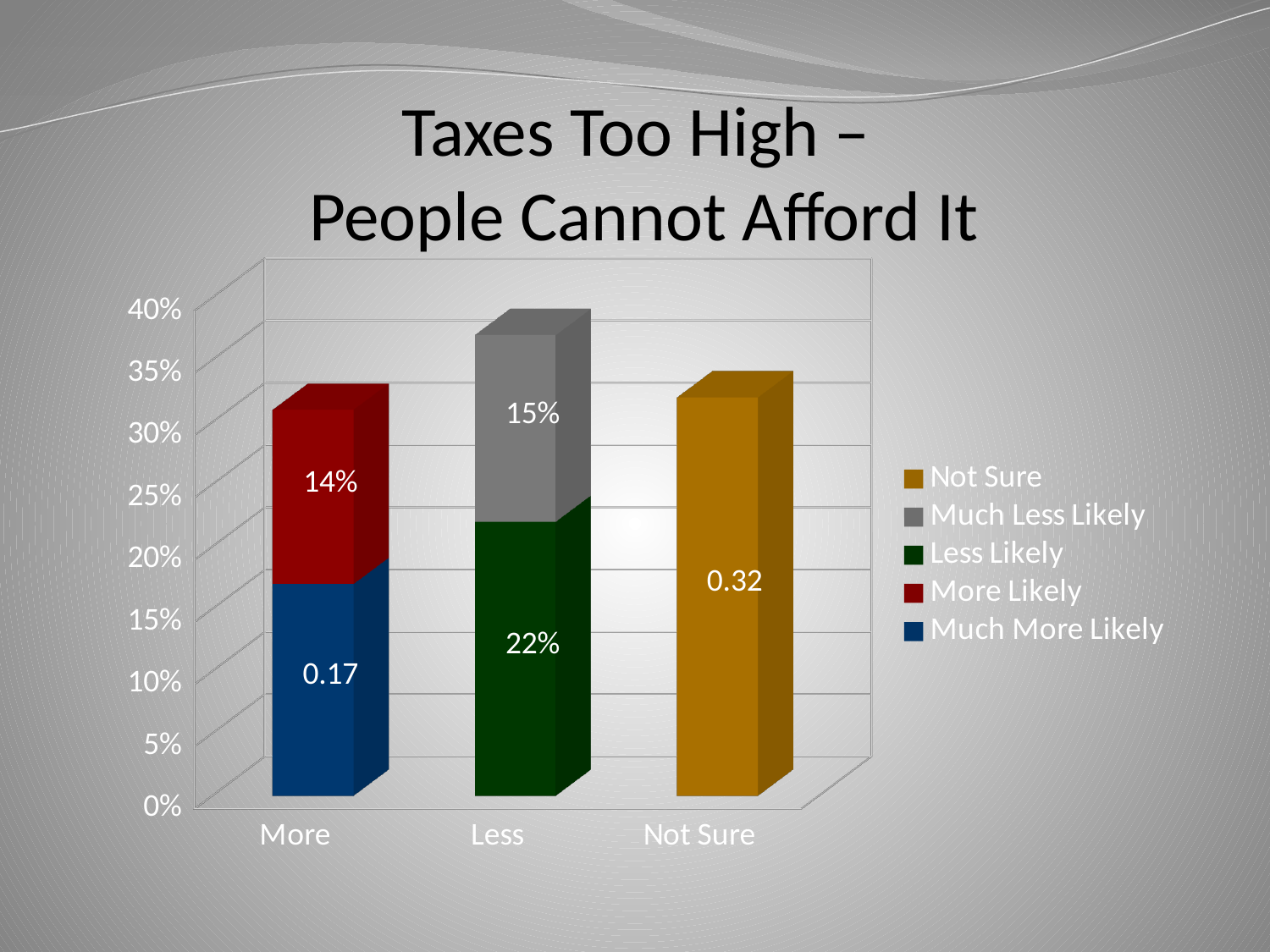
What is the difference between the Less Likely segment and the Much Less Likely segment in the Less bar? 7% Which category has the tallest bar overall? Less What is the value of the Much More Likely segment in the More bar? 0.17 What kind of chart is shown on the slide? Stacked bar chart How many series does the legend list? 5 What is the value of the Much Less Likely segment in the Less bar? 15% What is the value shown on the Not Sure bar? 0.32 What is the value of the Less Likely segment in the Less bar? 22% Which is larger in the Less bar, the Less Likely segment or the Much Less Likely segment? Less Likely How many categories are shown on the x axis? 3 What is the total of the stacked Less bar? 37% What is the value of the More Likely segment in the More bar? 14%